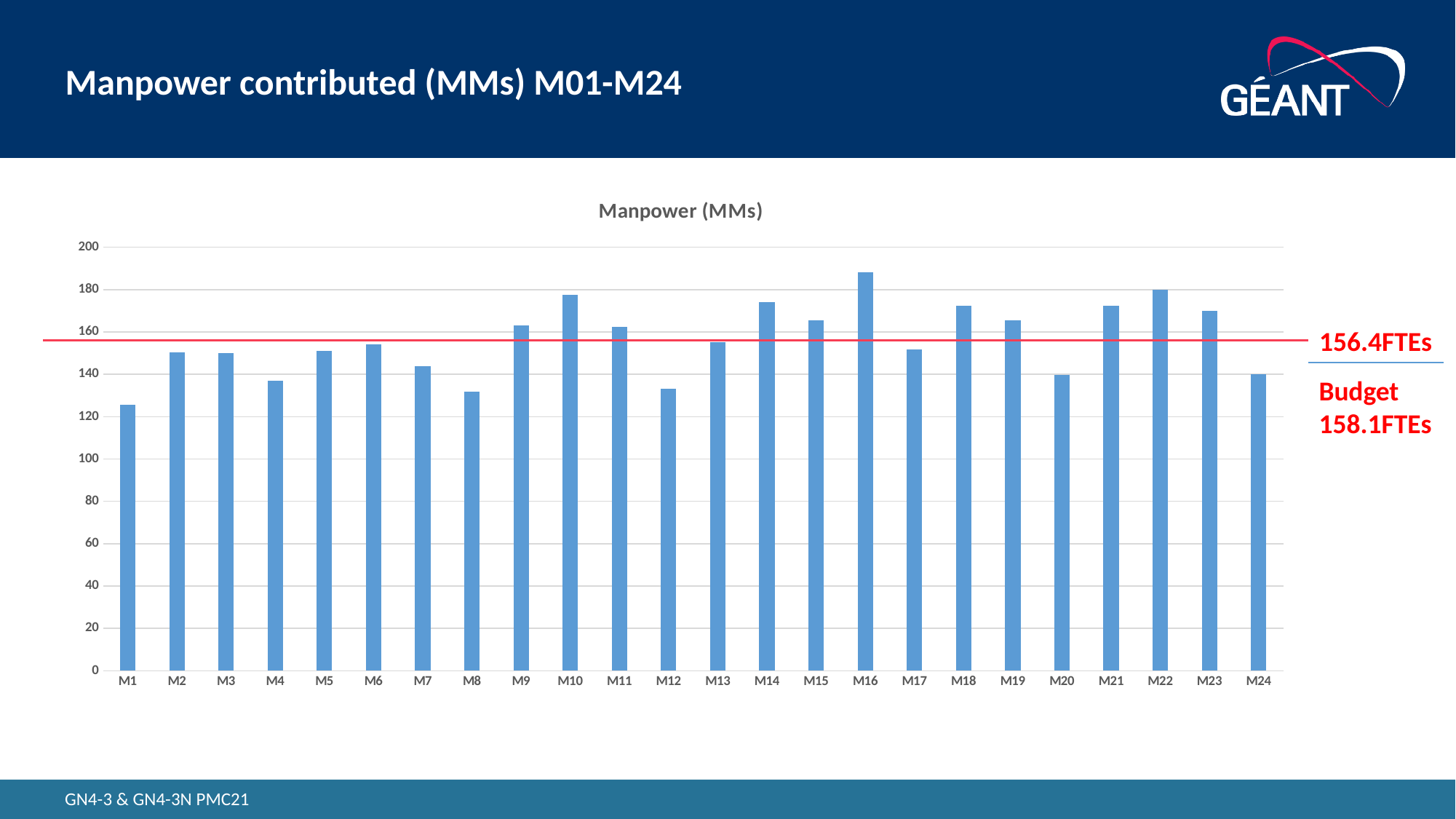
Is the value for M1 greater or less than 140? less Is the value for M22 greater or less than 160? greater Which month has the highest manpower value? M16 Is the value for M12 greater or less than 140? less What value is labelled on the red horizontal line across the chart? 156.4FTEs Which is larger, the value for M20 or the value for M22? M22 Which month has the lowest manpower value? M1 How many months (categories) are plotted on the x axis? 24 What kind of chart is shown on the slide? bar chart What is the title of the chart? Manpower (MMs) Which is larger, the value for M10 or the value for M12? M10